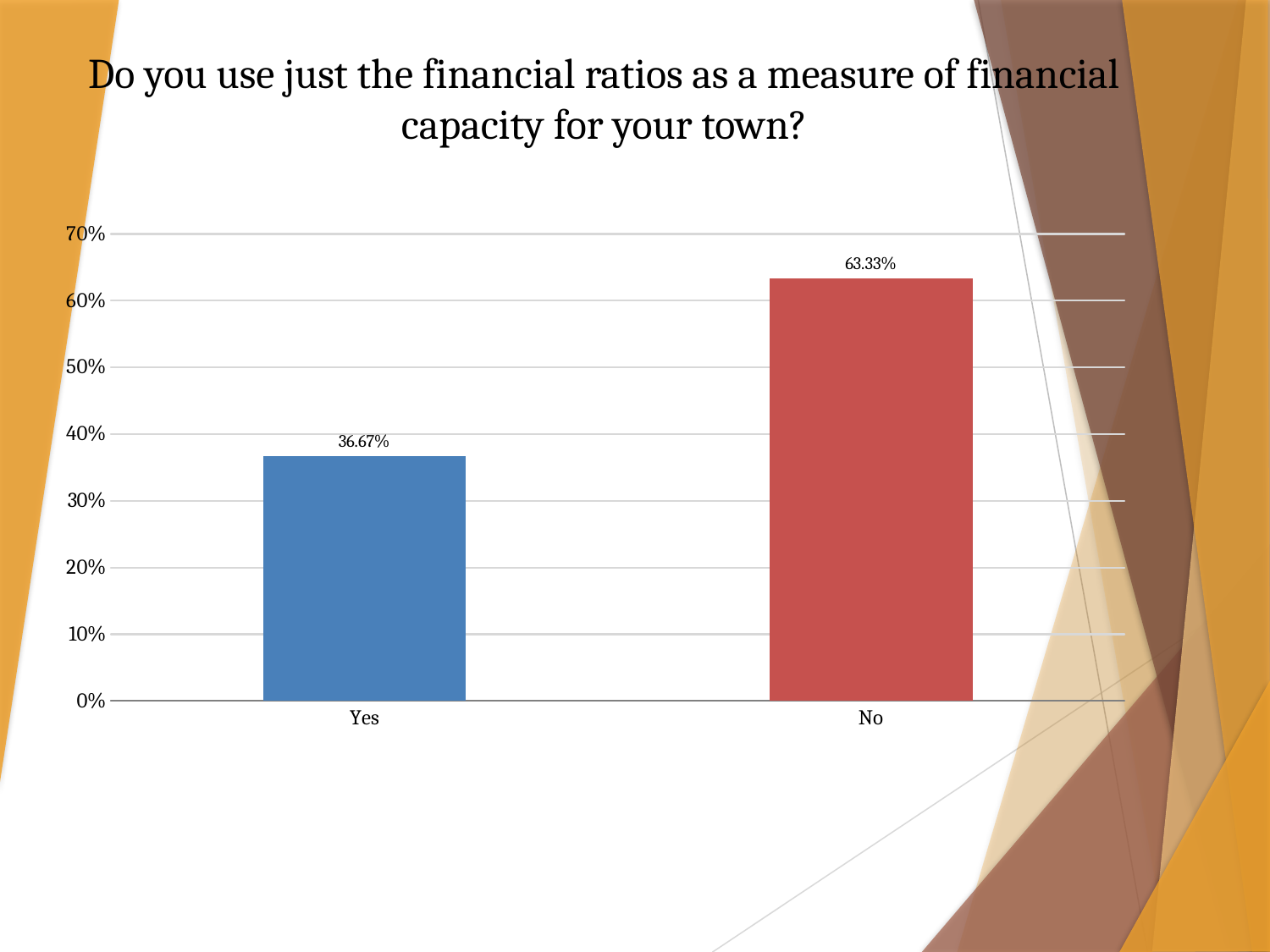
Is the value for Yes greater or less than 40%? less Is the value for No greater or less than 60%? greater What is the total of the Yes and No values? 100% Which category has the lowest value? Yes What colour is the bar for No? red What kind of chart is shown on the slide? bar chart What is the difference between the values for No and Yes? 26.66% What is the value for Yes? 36.67% How many categories are shown on the chart? 2 Which category has the highest value? No Which is larger, the value for Yes or the value for No? No What is the value for No? 63.33%